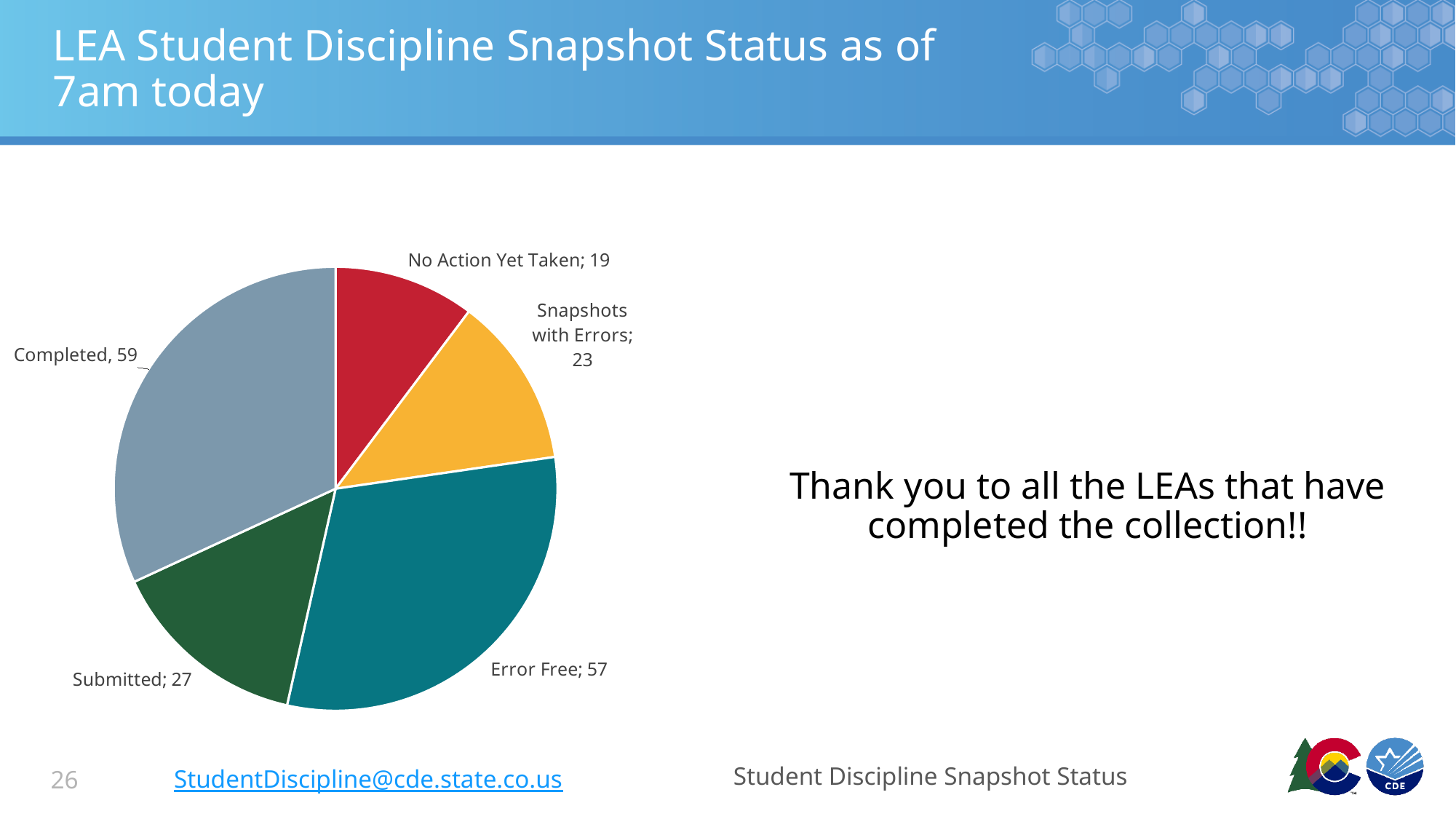
What is the value for Error Free? 57 What is the difference between Completed and Error Free? 2 What is the value for Completed? 59 What kind of chart is shown on the slide? pie chart What is the value for Snapshots with Errors? 23 What is the value for Submitted? 27 What is the value for No Action Yet Taken? 19 Which is larger, Submitted or Snapshots with Errors? Submitted What is the total of all slices in the pie chart? 185 Which category has the largest value? Completed Which category has the smallest value? No Action Yet Taken How many slices does the pie chart have? 5